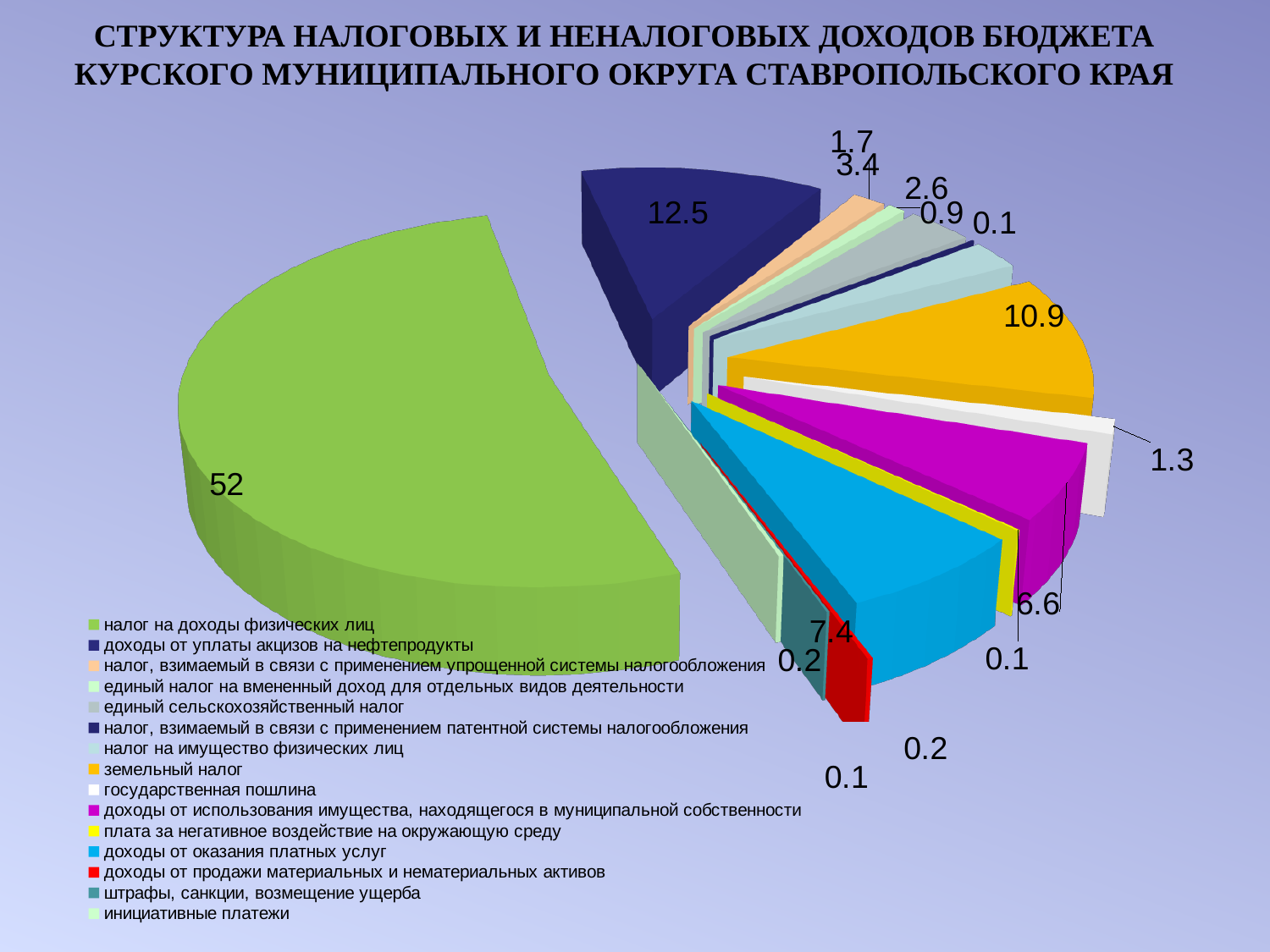
Which category has the largest slice of the pie? налог на доходы физических лиц Which is larger: доходы от оказания платных услуг or доходы от использования имущества, находящегося в муниципальной собственности? доходы от оказания платных услуг How many categories does the legend list? 15 What value is shown for доходы от уплаты акцизов на нефтепродукты? 12.5 What value is shown for земельный налог? 10.9 What is the difference between the values for налог на доходы физических лиц and доходы от уплаты акцизов на нефтепродукты? 39.5 What value is shown for доходы от оказания платных услуг? 7.4 What value is shown for налог на доходы физических лиц? 52 What value is shown for доходы от использования имущества, находящегося в муниципальной собственности? 6.6 What kind of chart is shown on the slide? pie chart Which is larger: земельный налог or доходы от уплаты акцизов на нефтепродукты? доходы от уплаты акцизов на нефтепродукты What value is shown for государственная пошлина? 1.3